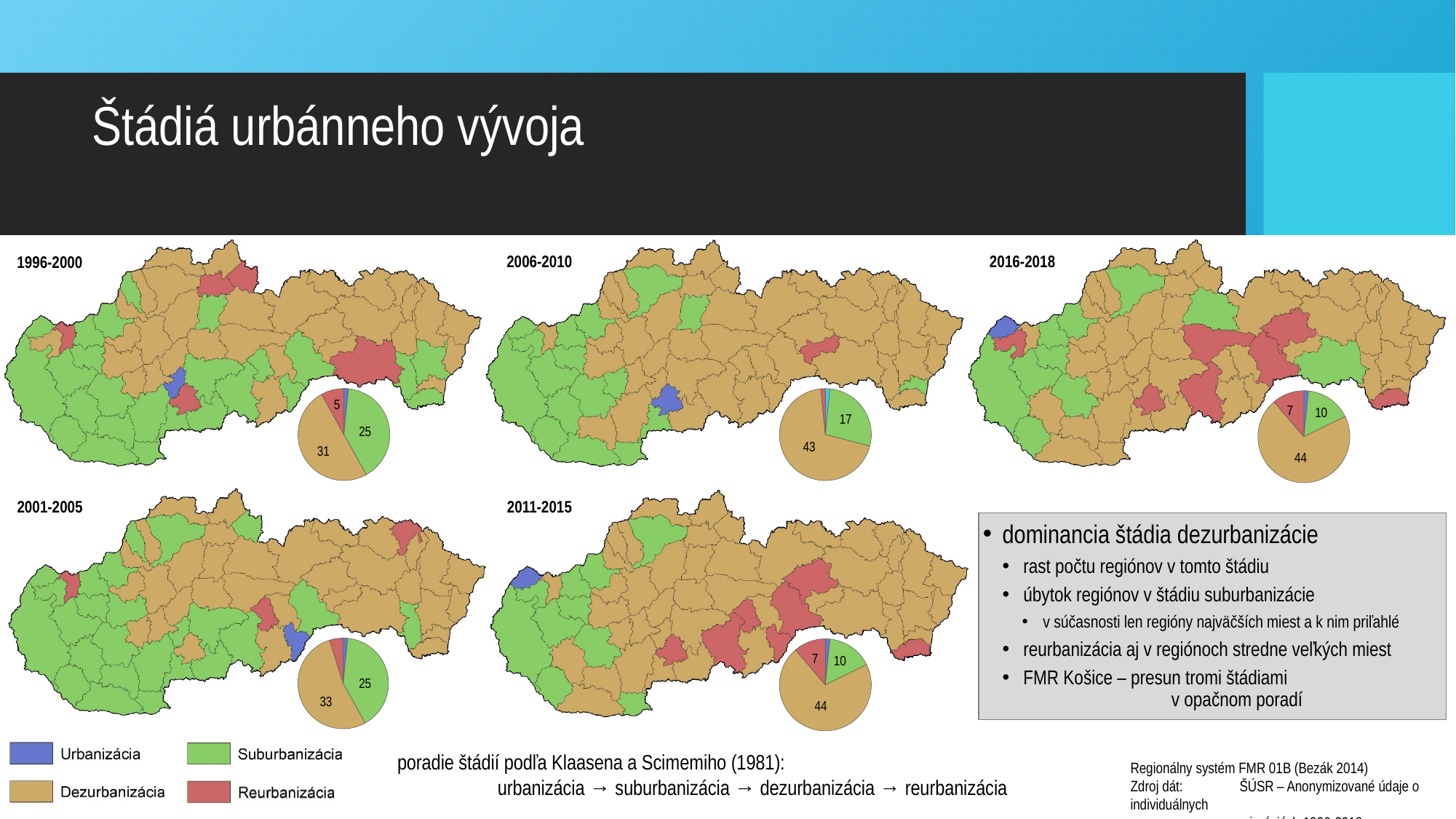
In the pie chart for 1996-2000, what value is shown for the Dezurbanizácia (tan) slice? 31 In the pie chart for 2016-2018, what is the difference between the Dezurbanizácia value and the Suburbanizácia value? 34 In the pie chart for 2001-2005, what value is shown for the Suburbanizácia (green) slice? 25 Comparing the pie charts for 1996-2000 and 2016-2018, which period has the larger Suburbanizácia value? 1996-2000 How many stages does the legend at the bottom left list? 4 What kind of chart is shown next to each map? Pie chart Which colour represents Urbanizácia in the legend? Blue In the pie chart for 2006-2010, what value is shown for the Dezurbanizácia (tan) slice? 43 In the pie chart for 1996-2000, what value is shown for the Reurbanizácia (red) slice? 5 In the pie chart for 2016-2018, what value is shown for the Reurbanizácia (red) slice? 7 In the pie chart for 2006-2010, what is the difference between the Dezurbanizácia value and the Suburbanizácia value? 26 In the pie chart for 2011-2015, which stage has the largest slice? Dezurbanizácia